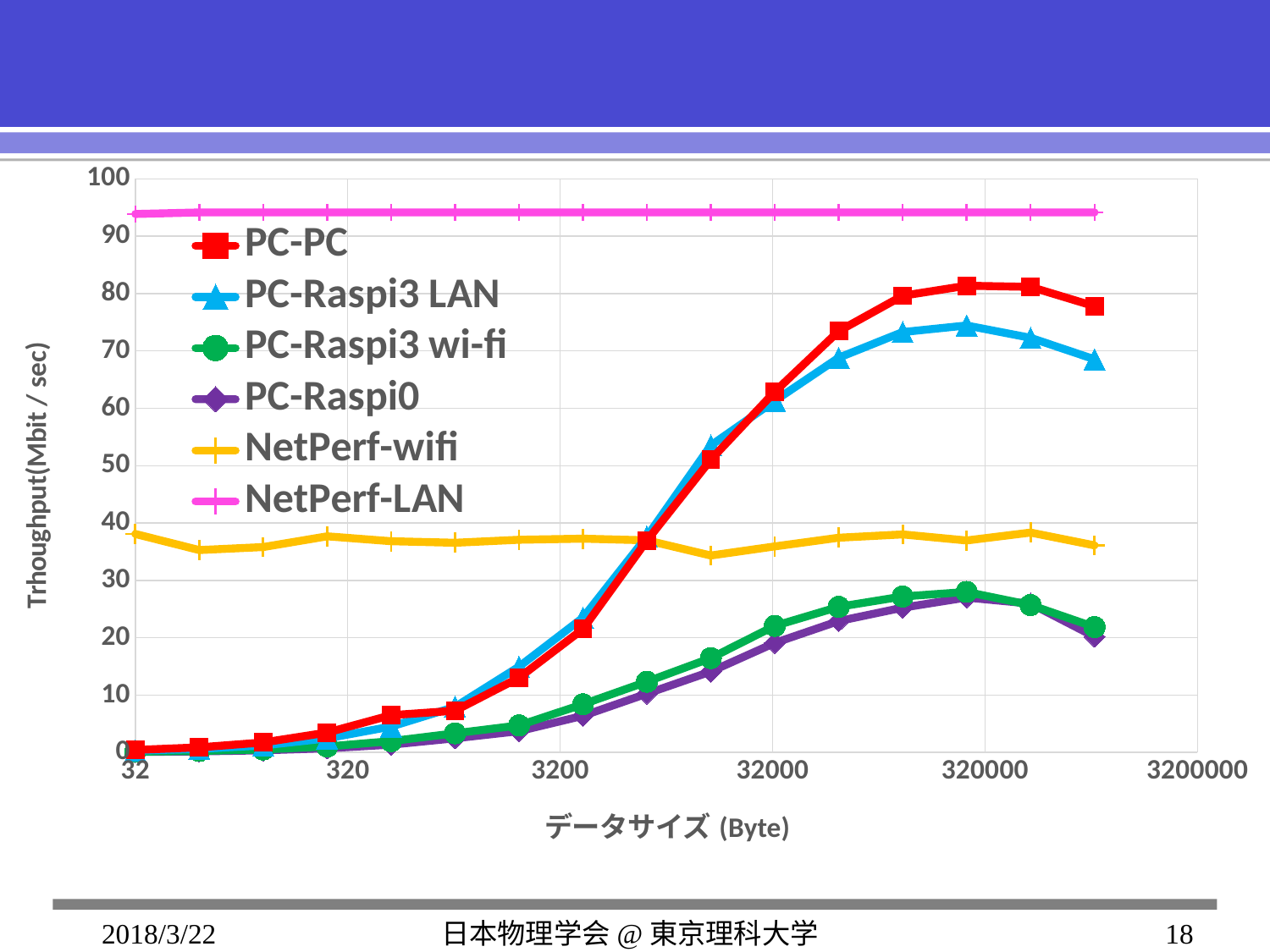
Is the throughput for PC-PC at a data size of 32000 Byte greater or less than 50? greater How many series does the legend list? 6 Is the throughput for NetPerf-wifi at a data size of 32000 Byte greater or less than 40? less Is the throughput for PC-PC at a data size of 320000 Byte greater or less than 70? greater At a data size of 320000 Byte, which series has the higher throughput, PC-PC or PC-Raspi3 LAN? PC-PC Which series is drawn in red with square markers? PC-PC Which series has the highest throughput across the whole range of data sizes? NetPerf-LAN How does the throughput for PC-PC change as the data size increases from 32 to 320000 Byte? it rises What is the label of the vertical axis? Trhoughput(Mbit / sec) What kind of chart is shown on the slide? line chart